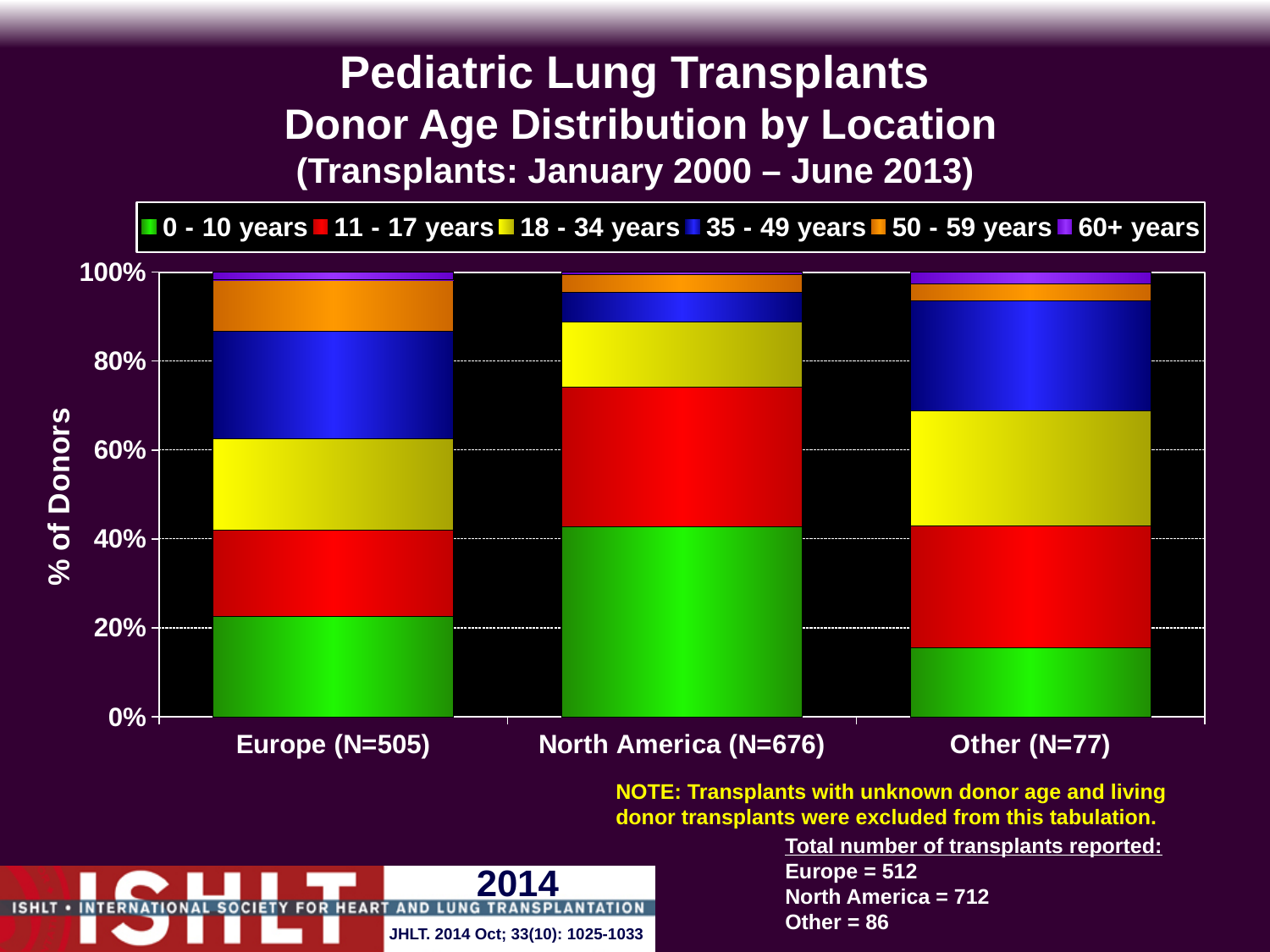
What is the N value shown for Europe on the x axis? 505 Which location has the smallest share of donors aged 0 - 10 years? Other (N=77) How many donor age groups does the legend list? 6 What is the N value shown for North America on the x axis? 676 Is the share of donors aged 0 - 10 years in Other greater or less than 20%? less Is the share of donors aged 0 - 10 years in North America greater or less than 20%? greater Is the share of donors aged 0 - 10 years in Europe larger or smaller than in North America? smaller Which location has the largest share of donors aged 0 - 10 years? North America (N=676) Which location has the smallest share of donors aged 35 - 49 years? North America (N=676) What kind of chart is shown on the slide? Stacked bar chart How many locations (categories) are shown on the x axis? 3 What is the label on the y axis? % of Donors